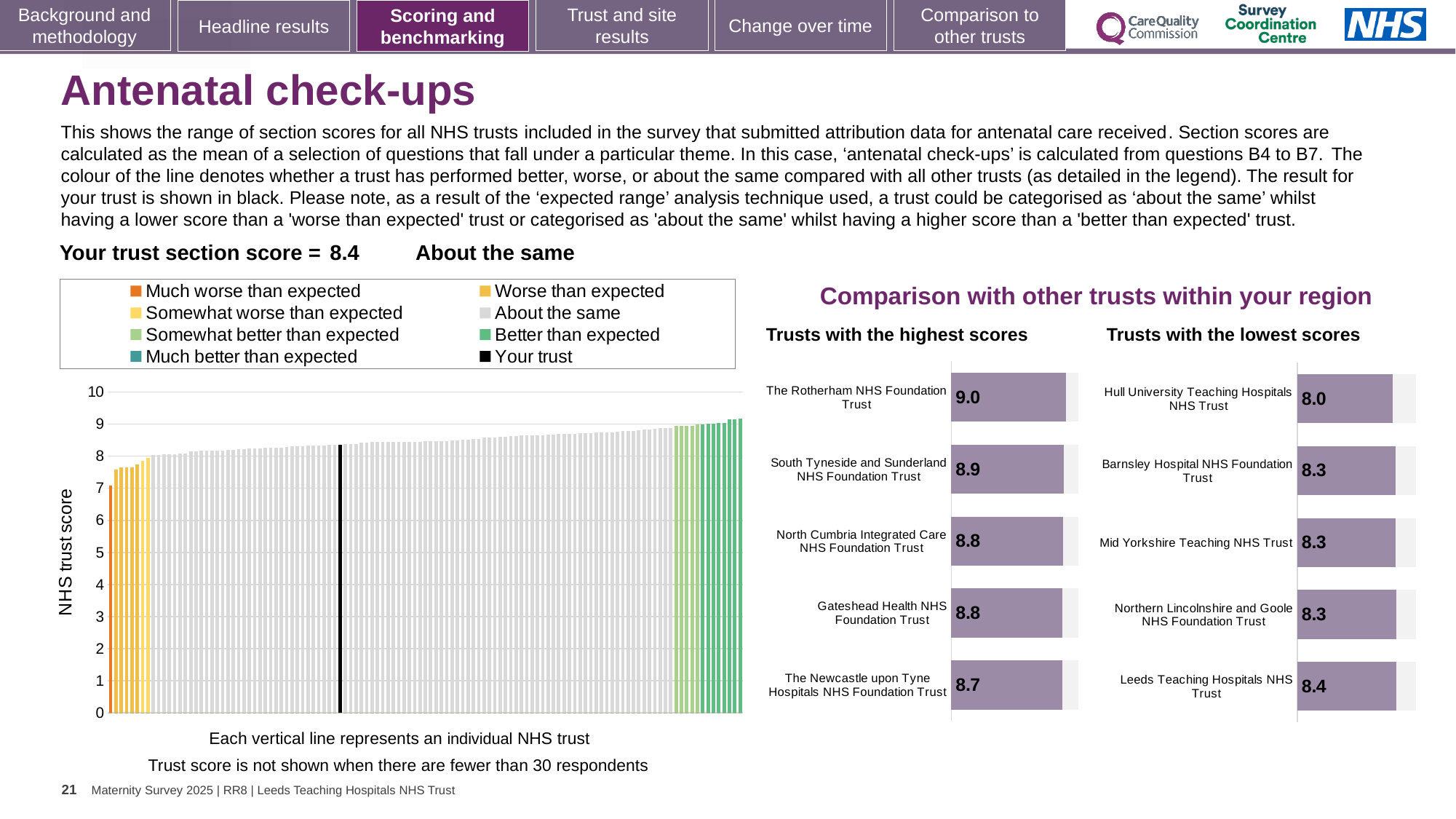
In the 'Trusts with the lowest scores' chart, what is the score for Hull University Teaching Hospitals NHS Trust? 8.0 In the 'Trusts with the lowest scores' chart, which trust has the highest score? Leeds Teaching Hospitals NHS Trust In the 'Trusts with the lowest scores' chart, what is the difference between the scores of Leeds Teaching Hospitals NHS Trust and Hull University Teaching Hospitals NHS Trust? 0.4 In the 'Trusts with the highest scores' chart, what is the score for The Rotherham NHS Foundation Trust? 9.0 In the left-hand NHS trust score chart, is the value of the leftmost (orange) bar greater or less than 8? less In the 'Trusts with the highest scores' chart, what is the difference between the scores of The Rotherham NHS Foundation Trust and South Tyneside and Sunderland NHS Foundation Trust? 0.1 In the 'Trusts with the lowest scores' chart, which has the larger score: Hull University Teaching Hospitals NHS Trust or Barnsley Hospital NHS Foundation Trust? Barnsley Hospital NHS Foundation Trust In the 'Trusts with the highest scores' chart, which trust has the lowest score? The Newcastle upon Tyne Hospitals NHS Foundation Trust How many entries does the legend of the left-hand NHS trust score chart list? 8 How many trusts are shown in the 'Trusts with the highest scores' chart? 5 In the left-hand NHS trust score chart, what is the section score for your trust (the black bar)? 8.4 In the 'Trusts with the highest scores' chart, what is the score for The Newcastle upon Tyne Hospitals NHS Foundation Trust? 8.7